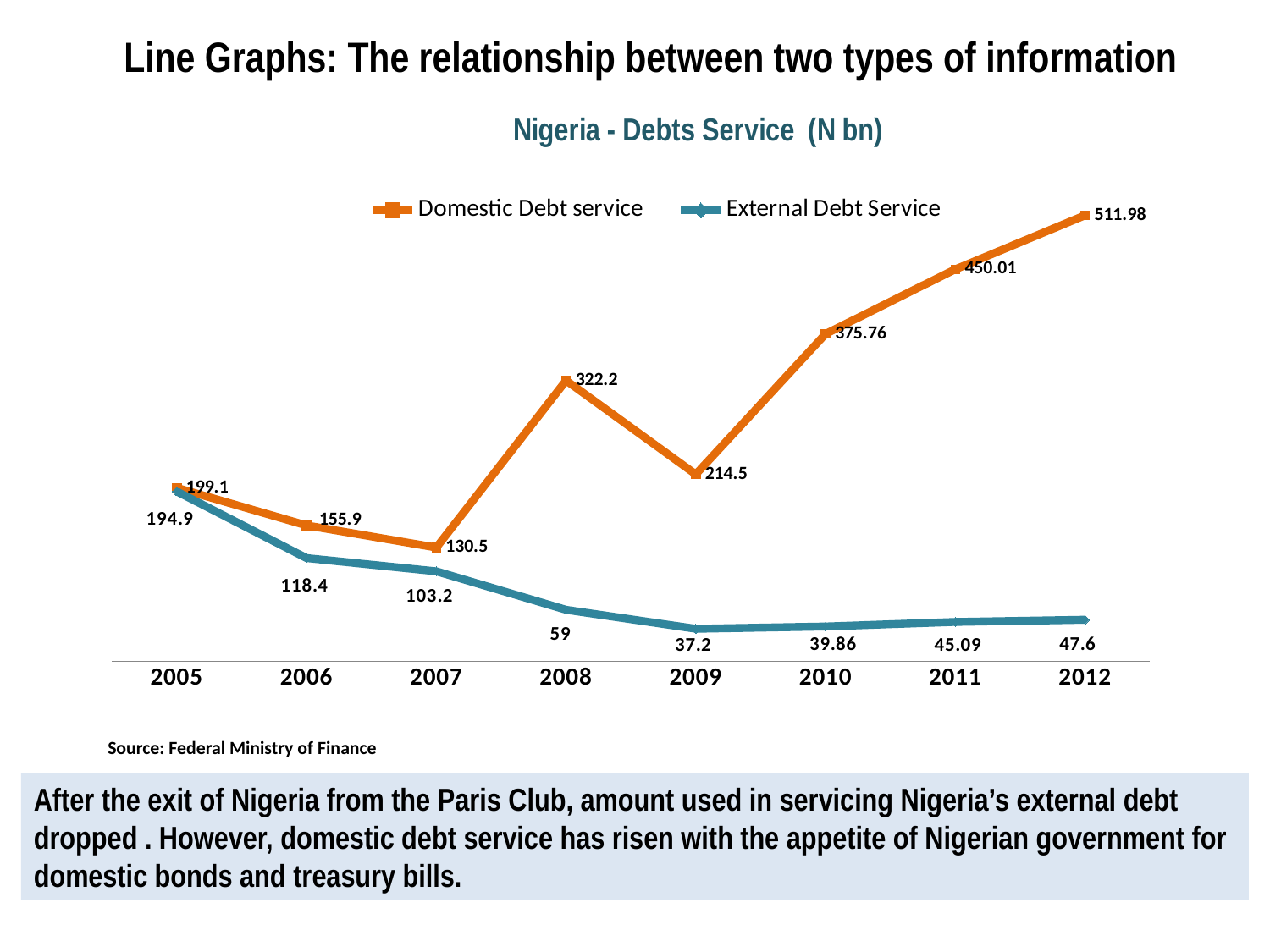
In which year is Domestic Debt service highest? 2012 Which is larger in 2007: Domestic Debt service or External Debt Service? Domestic Debt service What is the Domestic Debt service value for 2012? 511.98 In which year is External Debt Service lowest? 2009 What is the Domestic Debt service value for 2008? 322.2 Does External Debt Service rise or fall from 2005 to 2009? Fall What is the title of the chart? Nigeria - Debts Service (N bn) How many series does the legend list? 2 What is the difference between Domestic Debt service in 2012 and in 2011? 61.97 How many years are shown on the x axis? 8 What is the External Debt Service value for 2009? 37.2 What kind of chart is shown on the slide? Line chart